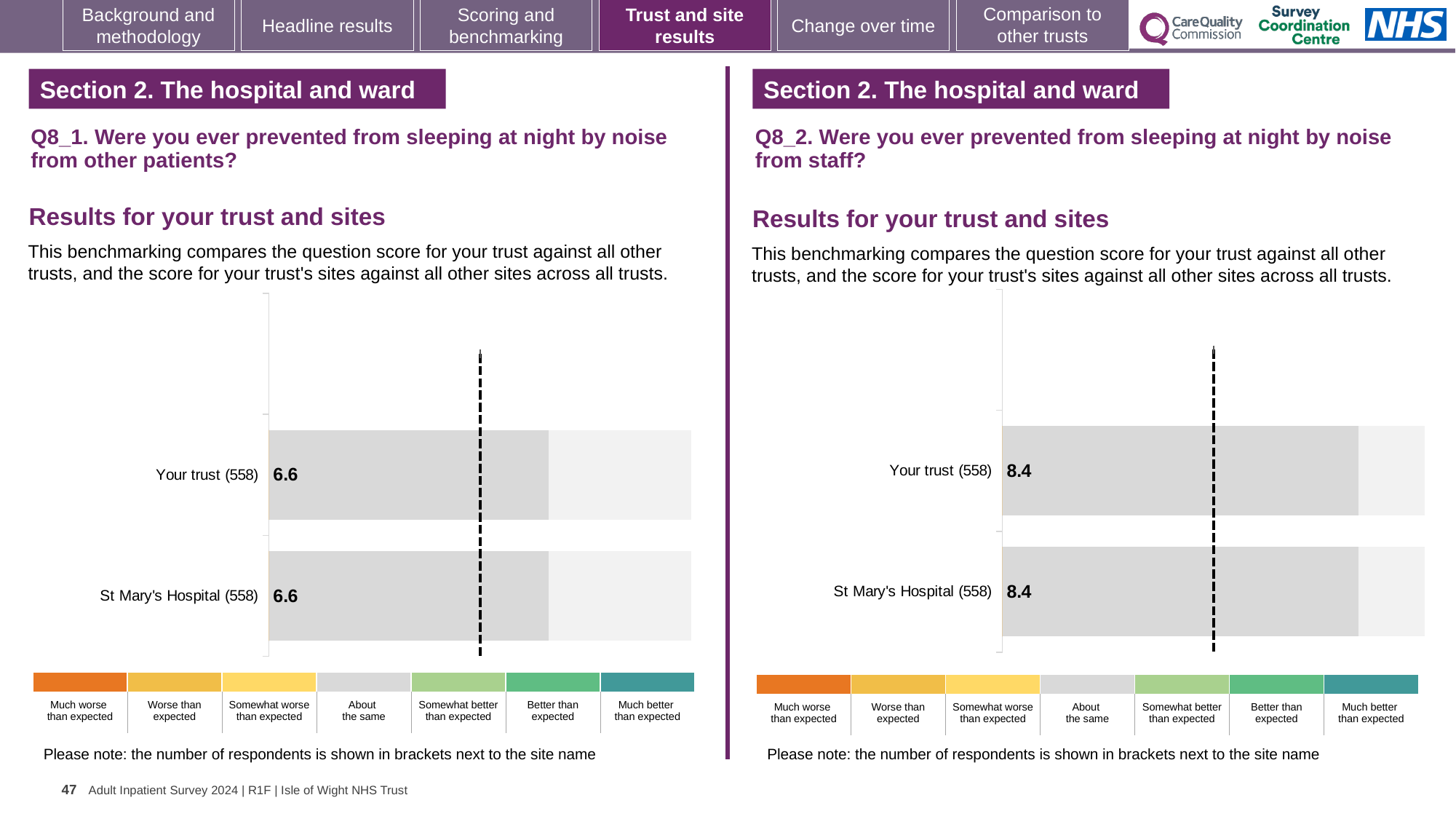
In the Q8_1 chart (left), what is the score for St Mary's Hospital? 6.6 How many bars are plotted in the Q8_1 chart (left)? 2 What is the difference between the Your trust score in the Q8_2 chart (right) and the Your trust score in the Q8_1 chart (left)? 1.8 What kind of chart is used for the Q8_2 results (right)? Bar chart In the Q8_2 chart (right), what is the score for Your trust? 8.4 In the Q8_1 chart (left), what is the score for Your trust? 6.6 Which is larger: the St Mary's Hospital score in the Q8_1 chart (left) or the St Mary's Hospital score in the Q8_2 chart (right)? Q8_2 chart (right) In the Q8_1 chart (left), how many respondents are shown in brackets next to St Mary's Hospital? 558 How many bars are plotted in the Q8_2 chart (right)? 2 In the Q8_1 chart (left), is the score for Your trust the same as the score for St Mary's Hospital? Yes How many rating categories does the colour key below the Q8_2 chart (right) list? 7 In the Q8_2 chart (right), what is the score for St Mary's Hospital? 8.4